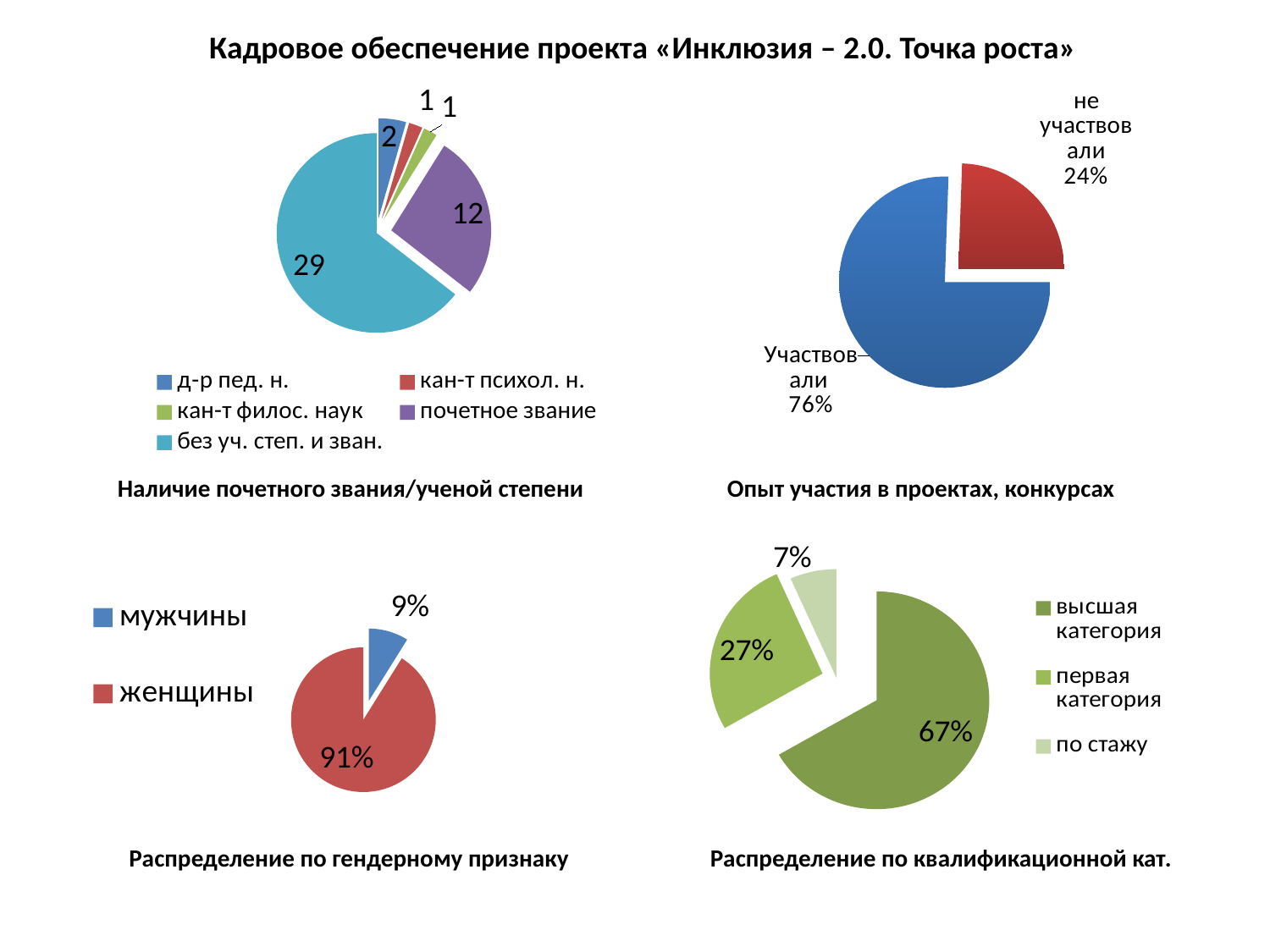
In the chart 'Опыт участия в проектах, конкурсах', which is larger: 'Участвовали' or 'не участвовали'? Участвовали In the chart 'Распределение по квалификационной кат.', what is the share for 'первая категория'? 27% In the chart 'Наличие почетного звания/ученой степени', which category has the highest value? без уч. степ. и зван. What type of chart is 'Распределение по квалификационной кат.'? Pie chart In the chart 'Наличие почетного звания/ученой степени', what is the value for 'почетное звание'? 12 In the chart 'Распределение по гендерному признаку', what is the difference between the shares of 'женщины' and 'мужчины'? 82% In the chart 'Распределение по квалификационной кат.', which category has the smallest share? по стажу In the chart 'Опыт участия в проектах, конкурсах', what share is labelled 'не участвовали'? 24% How many categories does the legend of the chart 'Наличие почетного звания/ученой степени' list? 5 In the chart 'Наличие почетного звания/ученой степени', what is the value for 'без уч. степ. и зван.'? 29 In the chart 'Наличие почетного звания/ученой степени', what is the difference between 'без уч. степ. и зван.' and 'почетное звание'? 17 In the chart 'Распределение по гендерному признаку', what is the share for 'женщины'? 91%